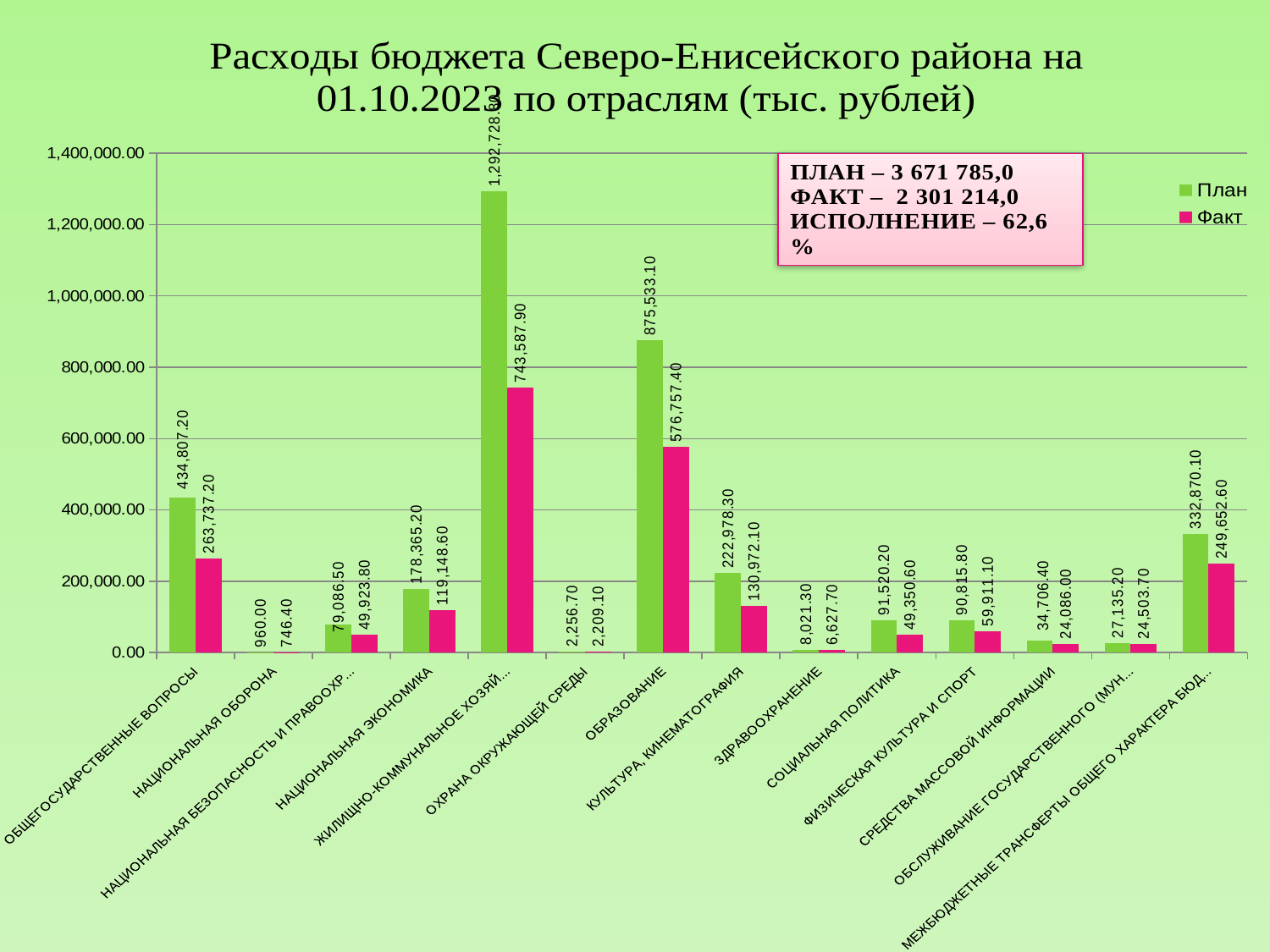
Which category has the highest План value? ЖИЛИЩНО-КОММУНАЛЬНОЕ ХОЗЯЙ... What is the difference between the План and Факт values for ОБРАЗОВАНИЕ? 298,775.70 Is the План value for ОБРАЗОВАНИЕ greater or less than 800,000.00? greater What is the Факт value for ЖИЛИЩНО-КОММУНАЛЬНОЕ ХОЗЯЙ...? 743,587.90 Which is larger: the Факт value for ОБЩЕГОСУДАРСТВЕННЫЕ ВОПРОСЫ or the Факт value for МЕЖБЮДЖЕТНЫЕ ТРАНСФЕРТЫ ОБЩЕГО ХАРАКТЕРА БЮД...? ОБЩЕГОСУДАРСТВЕННЫЕ ВОПРОСЫ How many series does the legend list? 2 What type of chart is shown on the slide? Bar chart Which category has the lowest Факт value? НАЦИОНАЛЬНАЯ ОБОРОНА What is the difference between the План and Факт values for ОБЩЕГОСУДАРСТВЕННЫЕ ВОПРОСЫ? 171,070.00 What is the План value for ОБРАЗОВАНИЕ? 875,533.10 What is the Факт value for КУЛЬТУРА, КИНЕМАТОГРАФИЯ? 130,972.10 What execution percentage (ИСПОЛНЕНИЕ) is stated in the text box on the chart? 62,6 %